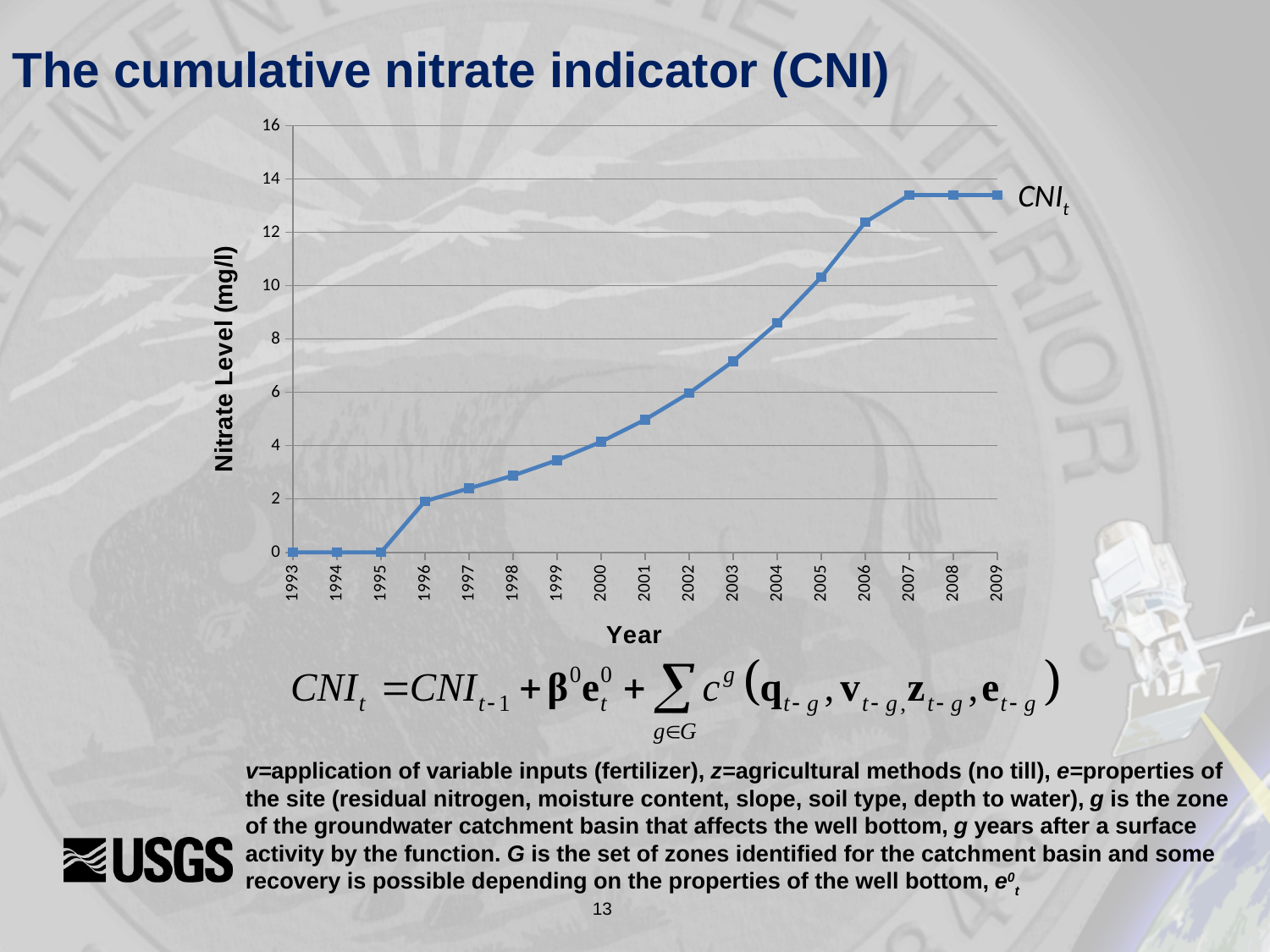
What is the title of the x axis? Year What kind of chart is shown on the slide? line chart How many years (data points) are plotted along the x axis? 17 Is the value for 2004 greater or less than 8? greater Is the value for 2006 greater or less than 12? greater What is the title of the y axis? Nitrate Level (mg/l) Is the value for 2008 greater or less than 14? less Which year has the larger value, 2004 or 2006? 2006 Do the plotted values generally rise or fall from 1993 to 2009? rise What is the nitrate level value plotted for 1993? 0